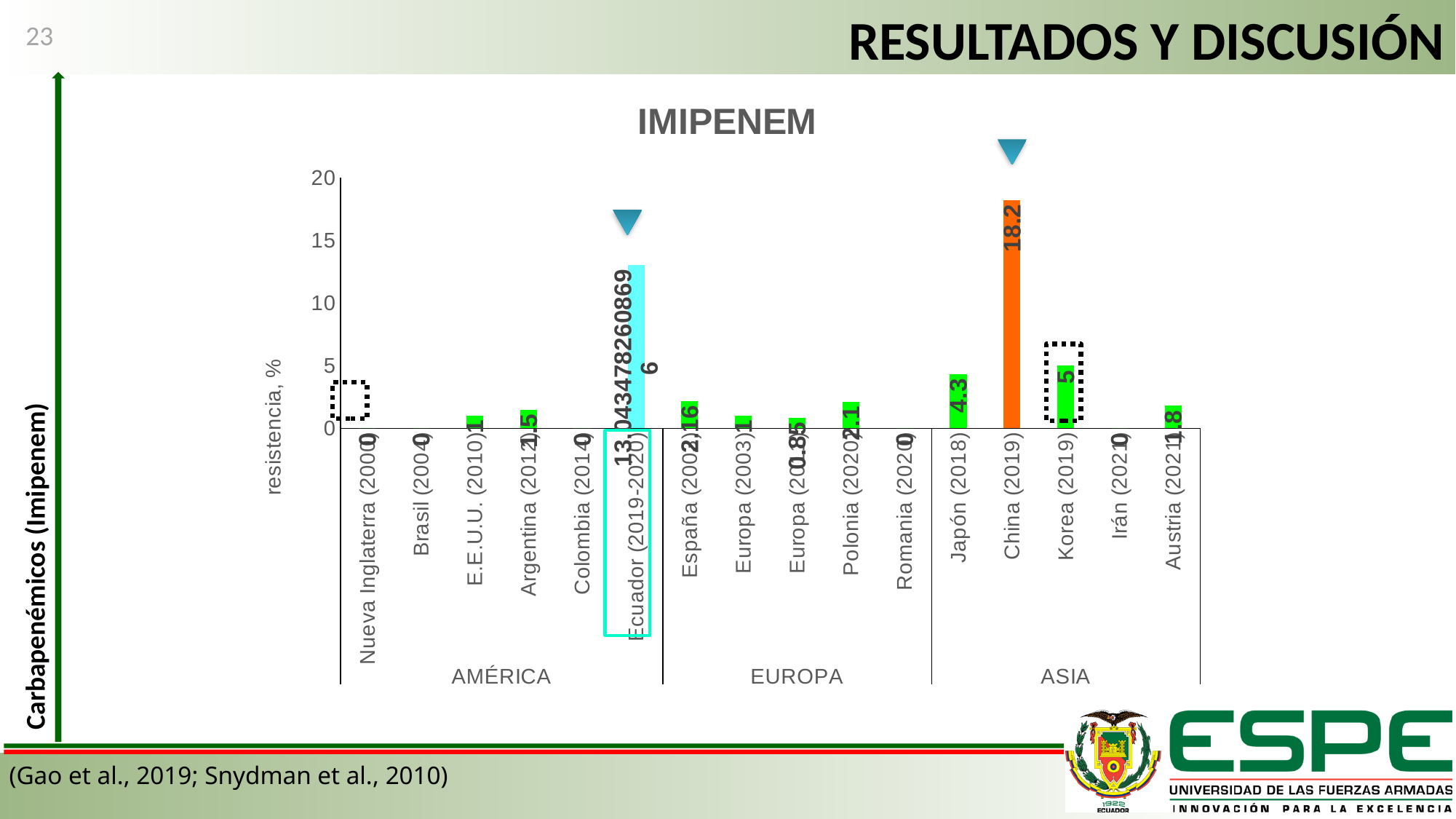
What kind of chart is shown on the slide? bar chart What is the resistance value for Korea (2019)? 5 Which category has the highest resistance value? China (2019) How many categories are plotted on the x axis? 16 What is the title of the chart? IMIPENEM Is the value for Ecuador (2019-2020) greater or less than 10? greater Which is larger, the value for Japón (2018) or Korea (2019)? Korea (2019) What is the resistance value for Austria (2021)? 1.8 What is the difference between the values for China (2019) and Korea (2019)? 13.2 What is the resistance value for China (2019)? 18.2 What is the resistance value for Japón (2018)? 4.3 What is the label of the y axis? resistencia, %